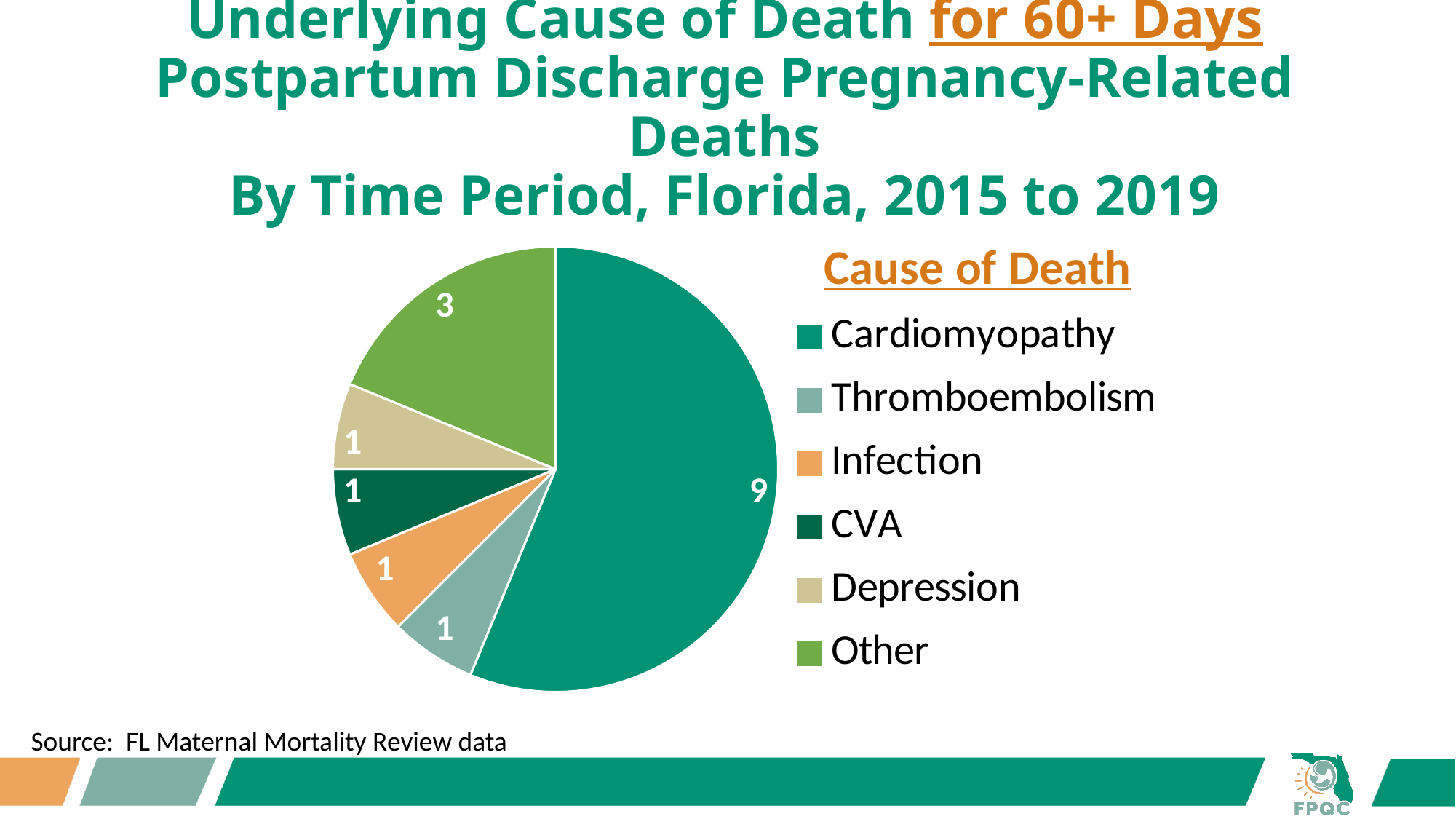
How many deaths are attributed to Other in the pie chart? 3 What is the title of the legend on the slide? Cause of Death How many deaths are attributed to Thromboembolism in the pie chart? 1 What is the source cited for the chart data? FL Maternal Mortality Review data Which cause of death has the largest slice in the pie chart? Cardiomyopathy What is the difference between the number of Cardiomyopathy deaths and Other deaths? 6 What share of the total deaths does the Cardiomyopathy slice represent? 56.25% Which is larger, the value for Other or the value for Infection? Other How many categories does the pie chart's legend list? 6 What is the total number of deaths shown across all slices of the pie chart? 16 What kind of chart is shown on the slide? Pie chart How many deaths are attributed to Cardiomyopathy in the pie chart? 9